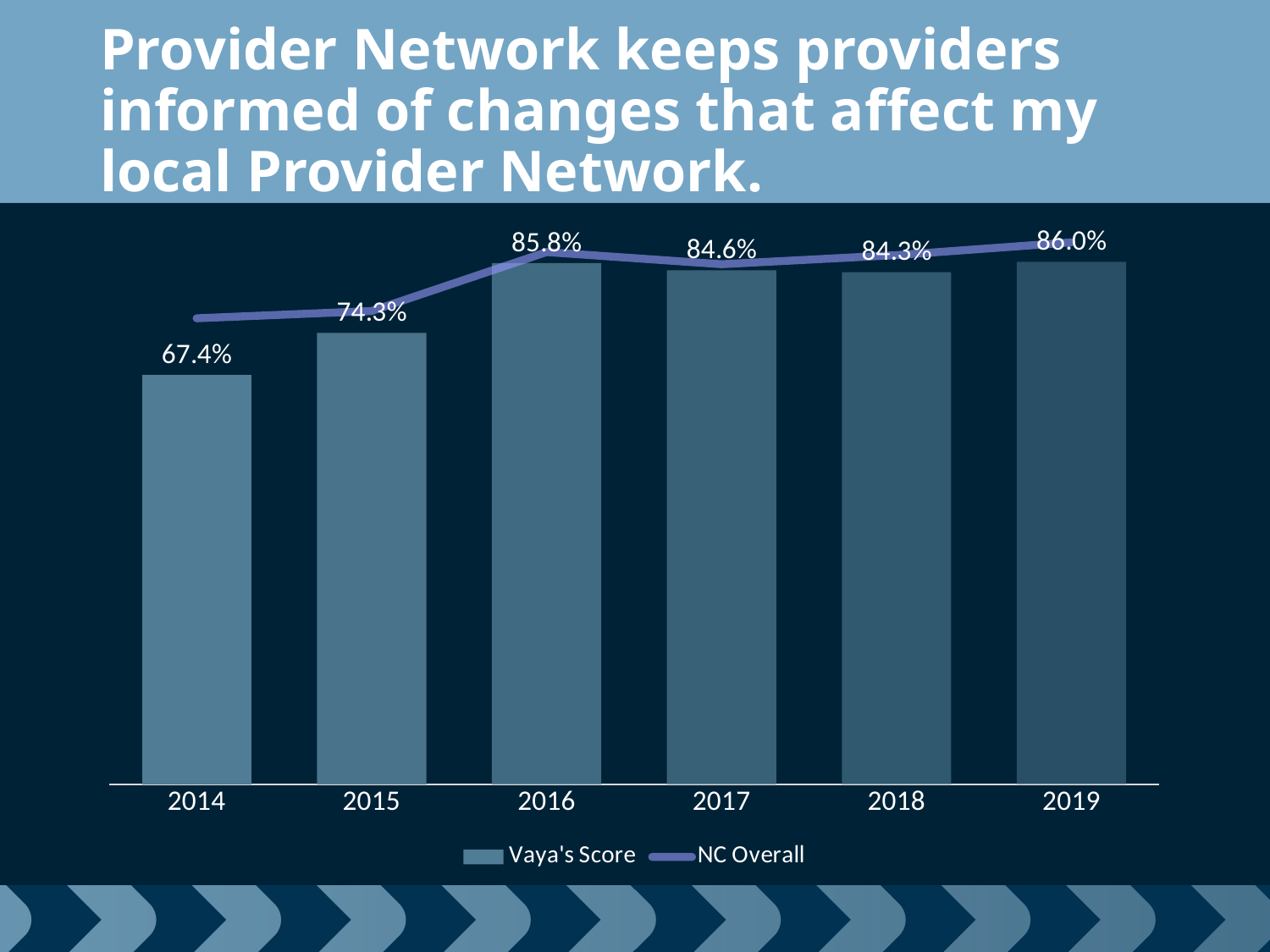
Which year has the lowest Vaya's Score? 2014 What is Vaya's Score for 2019? 86.0% How many years are shown on the x axis? 6 Is Vaya's Score higher in 2015 or in 2018? 2018 How many series does the legend list? 2 Which year has the highest Vaya's Score? 2019 What is Vaya's Score for 2014? 67.4% What is the difference between Vaya's Score in 2016 and 2017? 1.2% Which series is drawn as a line? NC Overall What kind of chart is used to show Vaya's Score? bar chart What is the difference between Vaya's Score in 2015 and 2014? 6.9% What is Vaya's Score for 2016? 85.8%